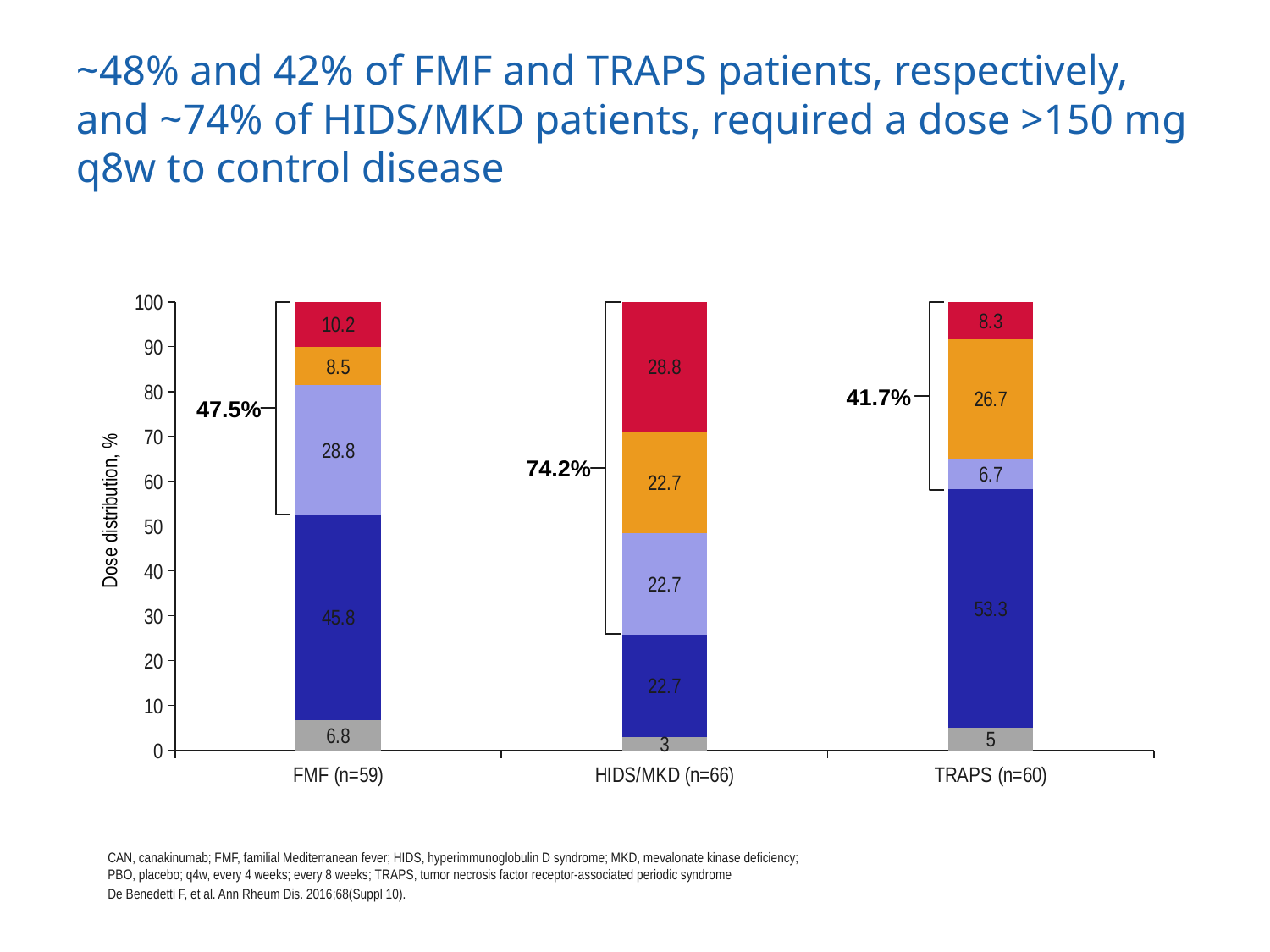
What percentage is annotated by the bracket next to the HIDS/MKD (n=66) bar? 74.2% What is the value of the red (top) segment for HIDS/MKD (n=66)? 28.8 What is the difference between the dark blue segment for TRAPS (n=60) and the dark blue segment for FMF (n=59)? 7.5 Which patient group has the smallest grey (bottom) segment? HIDS/MKD (n=66) What kind of chart is shown on the slide? Stacked bar chart What is the label of the y axis? Dose distribution, % What is the value of the dark blue segment for FMF (n=59)? 45.8 Which patient group has the largest dark blue segment? TRAPS (n=60) What is the value of the orange segment for TRAPS (n=60)? 26.7 What is the value of the grey (bottom) segment for HIDS/MKD (n=66)? 3 Is the light blue segment larger for FMF (n=59) or for TRAPS (n=60)? FMF (n=59) How many patient groups (bars) are shown on the x axis? 3